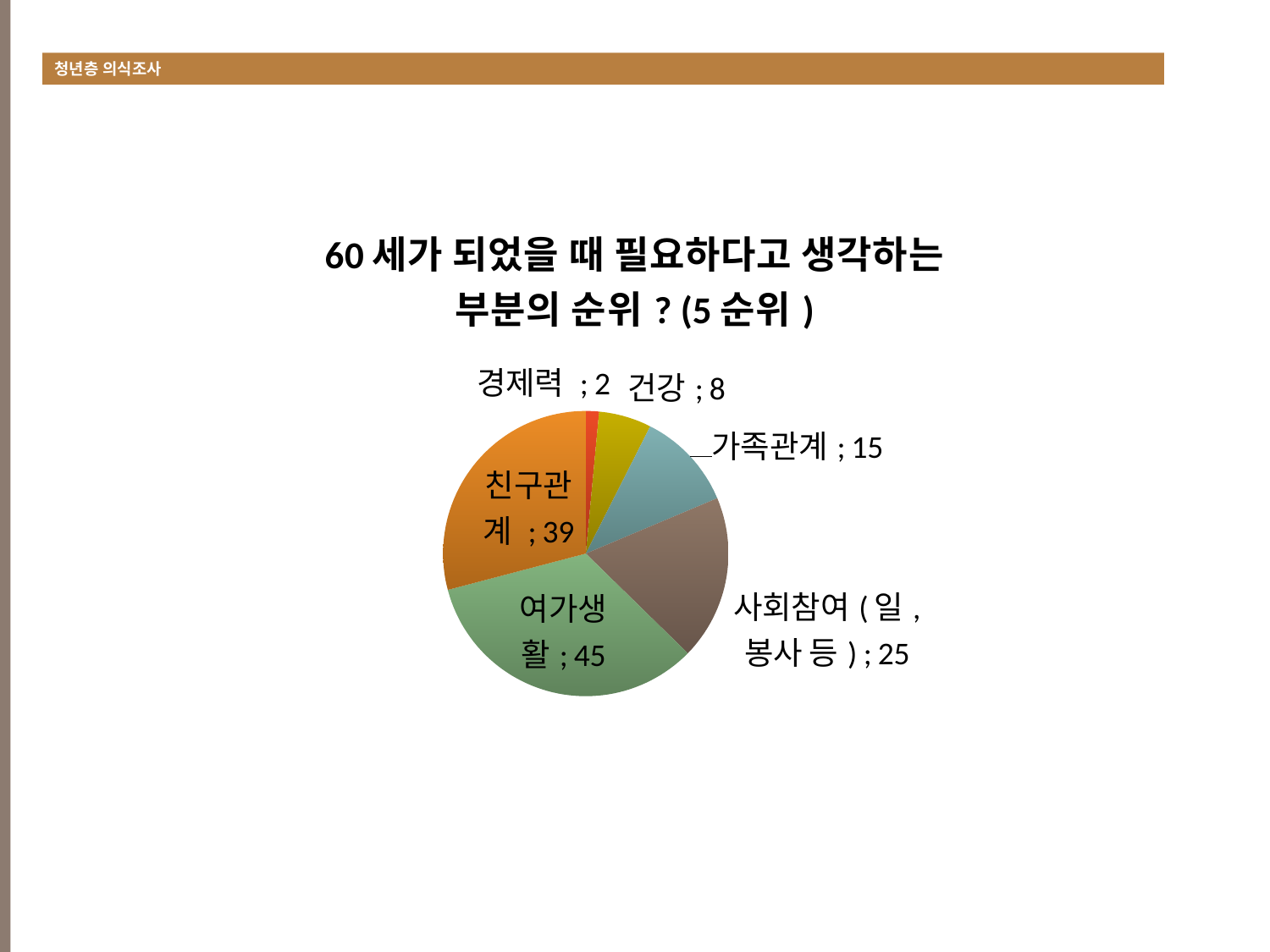
Which category has the largest slice in the pie chart? 여가생활 What is the value for 가족관계 in the pie chart? 15 What is the difference between the values for 여가생활 and 친구관계? 6 How many categories are shown in the pie chart? 6 Which is larger, the value for 가족관계 or the value for 건강? 가족관계 What is the value for 건강 in the pie chart? 8 Which category has the smallest slice in the pie chart? 경제력 What is the value for 사회참여 (일, 봉사 등) in the pie chart? 25 What is the sum of all the values shown in the pie chart? 134 What is the value for 친구관계 in the pie chart? 39 What type of chart is shown on the slide? Pie chart What is the value for 여가생활 in the pie chart? 45